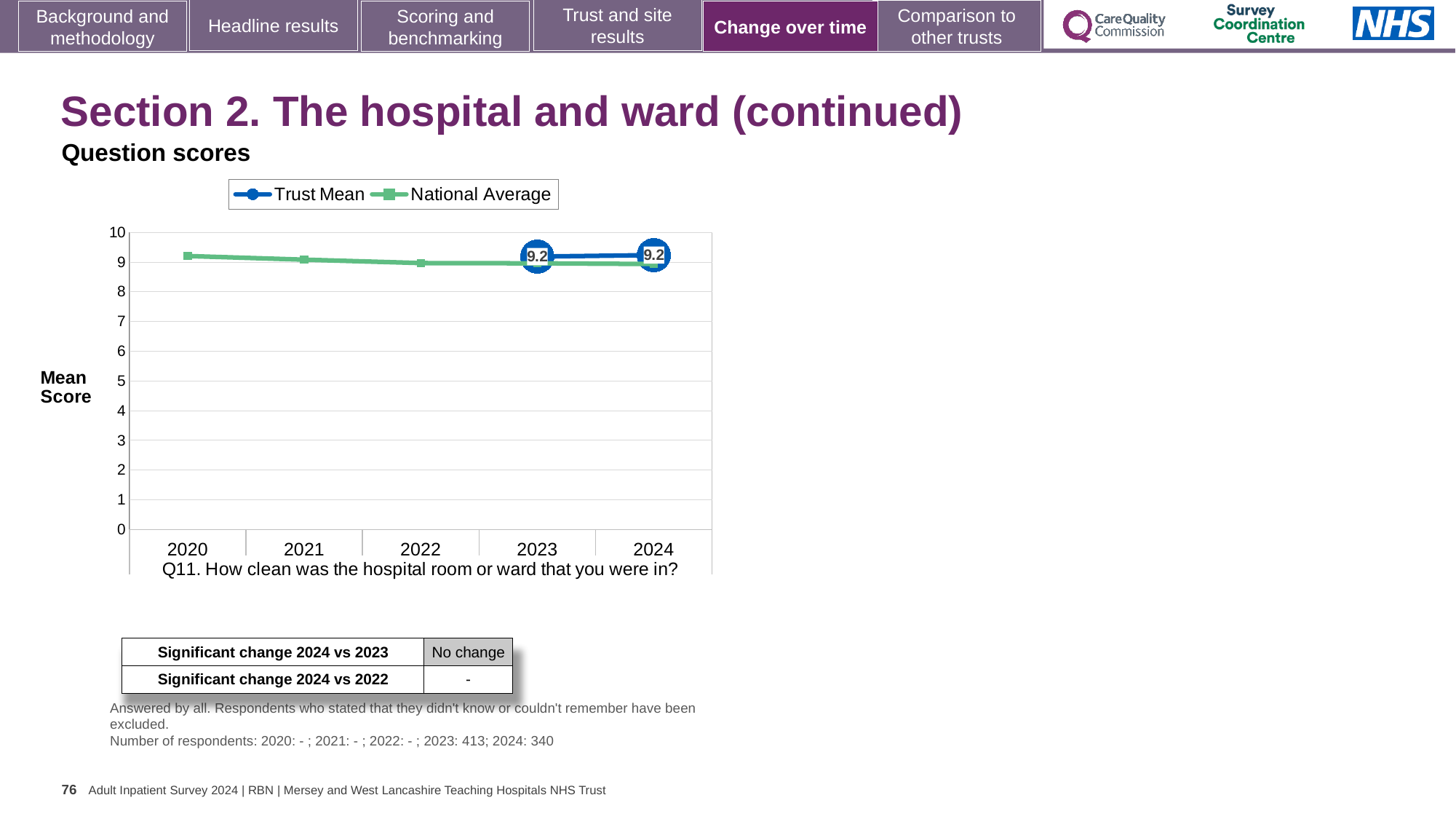
What is the Trust Mean value for 2023? 9.2 How many data points are plotted for the Trust Mean series? 2 Which survey question does the chart show results for? Q11. How clean was the hospital room or ward that you were in? How many years are shown on the x axis? 5 Is the National Average value for 2022 greater or less than 5? greater Is the National Average value for 2020 greater or less than 8? greater What is the difference between the Trust Mean values for 2024 and 2023? 0 What is the Trust Mean value for 2024? 9.2 Does the National Average rise or fall from 2020 to 2024? fall What kind of chart is shown on the slide? Line chart What is the label on the y axis of the chart? Mean Score How many series does the legend list? 2